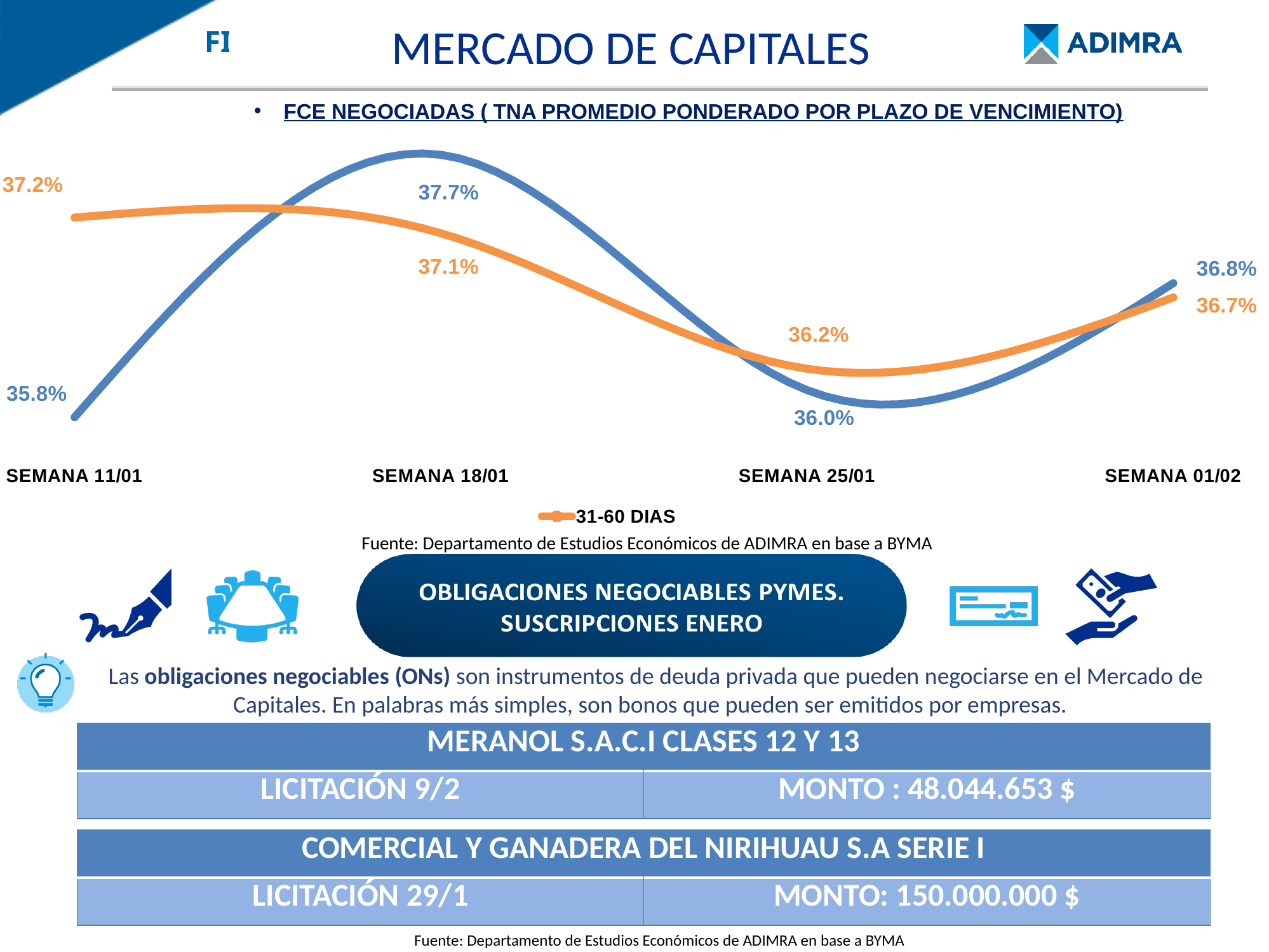
What kind of chart is shown on the slide? Line chart Does the 31-60 DIAS series rise or fall from SEMANA 11/01 to SEMANA 25/01? Fall How many series does the chart legend list? 1 What is the value of the 31-60 DIAS series at SEMANA 01/02? 36.7% In which week does the blue line reach its highest value? SEMANA 18/01 What is the value of the 31-60 DIAS series at SEMANA 11/01? 37.2% What is the value of the blue line at SEMANA 18/01? 37.7% What is the value of the 31-60 DIAS series at SEMANA 25/01? 36.2% In which week does the 31-60 DIAS series reach its lowest value? SEMANA 25/01 At SEMANA 18/01, which line has the higher value, the blue line or the orange 31-60 DIAS line? The blue line How many weeks are shown on the x axis of the chart? 4 What is the difference between the 31-60 DIAS values at SEMANA 11/01 and SEMANA 25/01? 1.0 percentage points